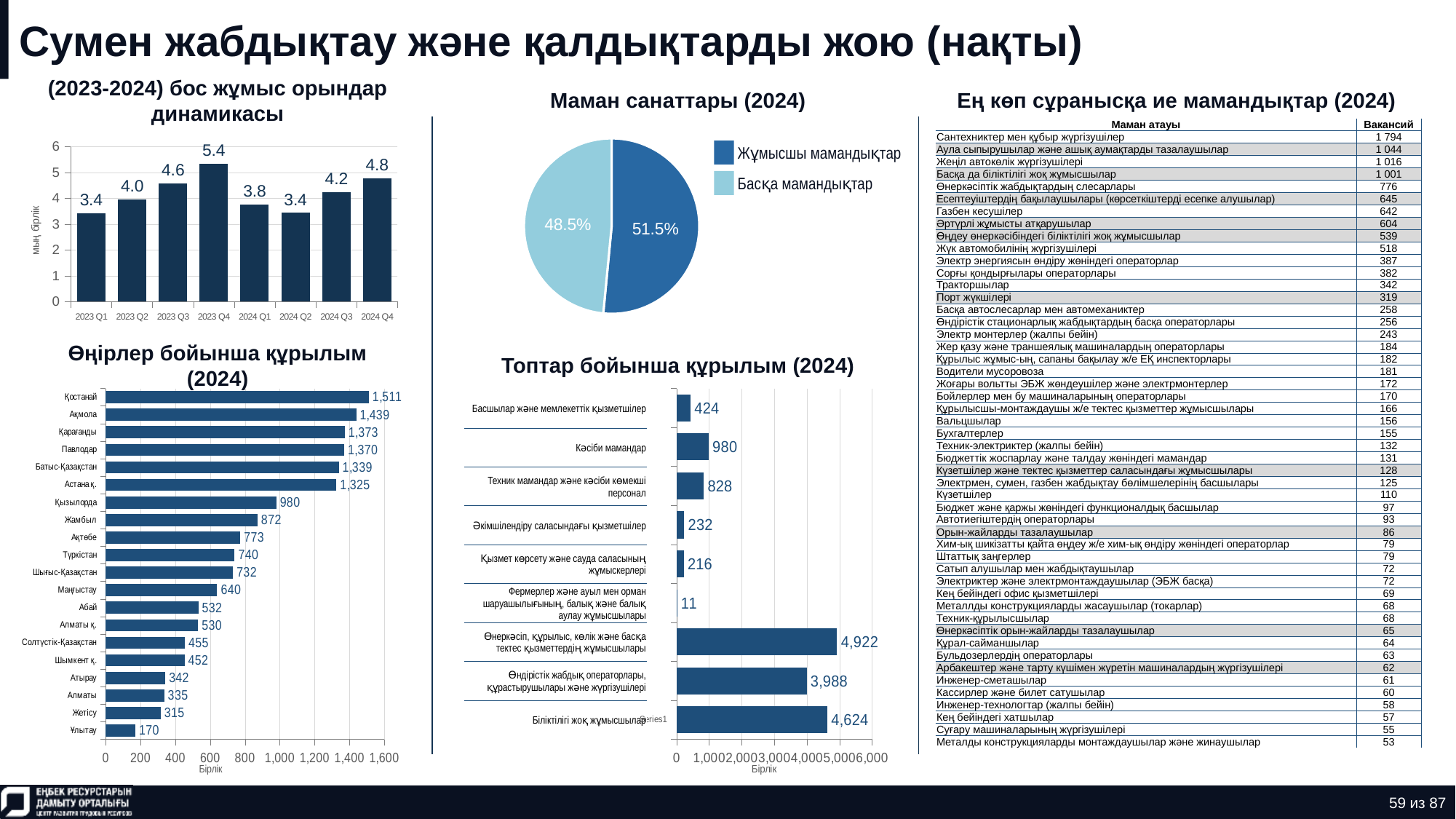
What kind of chart is 'Топтар бойынша құрылым (2024)'? bar chart In the chart 'Өңірлер бойынша құрылым (2024)', which region has the highest value? Қостанай In the chart 'Топтар бойынша құрылым (2024)', which group has the lowest value? Фермерлер және ауыл мен орман шаруашылығының, балық және балық аулау жұмысшылары In the chart '(2023-2024) бос жұмыс орындар динамикасы', what is the difference between 2024 Q4 and 2024 Q1? 1.0 In the chart 'Өңірлер бойынша құрылым (2024)', what is the value for Ұлытау? 170 In the chart '(2023-2024) бос жұмыс орындар динамикасы', what is the value for 2023 Q4? 5.4 In the chart 'Өңірлер бойынша құрылым (2024)', which is larger, Жамбыл or Ақтөбе? Жамбыл In the chart '(2023-2024) бос жұмыс орындар динамикасы', which quarter has the highest value? 2023 Q4 In the pie chart 'Маман санаттары (2024)', what share is 'Жұмысшы мамандықтар'? 51.5% In the chart '(2023-2024) бос жұмыс орындар динамикасы', how many quarters are plotted? 8 In the pie chart 'Маман санаттары (2024)', how many categories does the legend list? 2 In the chart 'Топтар бойынша құрылым (2024)', what is the value for 'Кәсіби мамандар'? 980